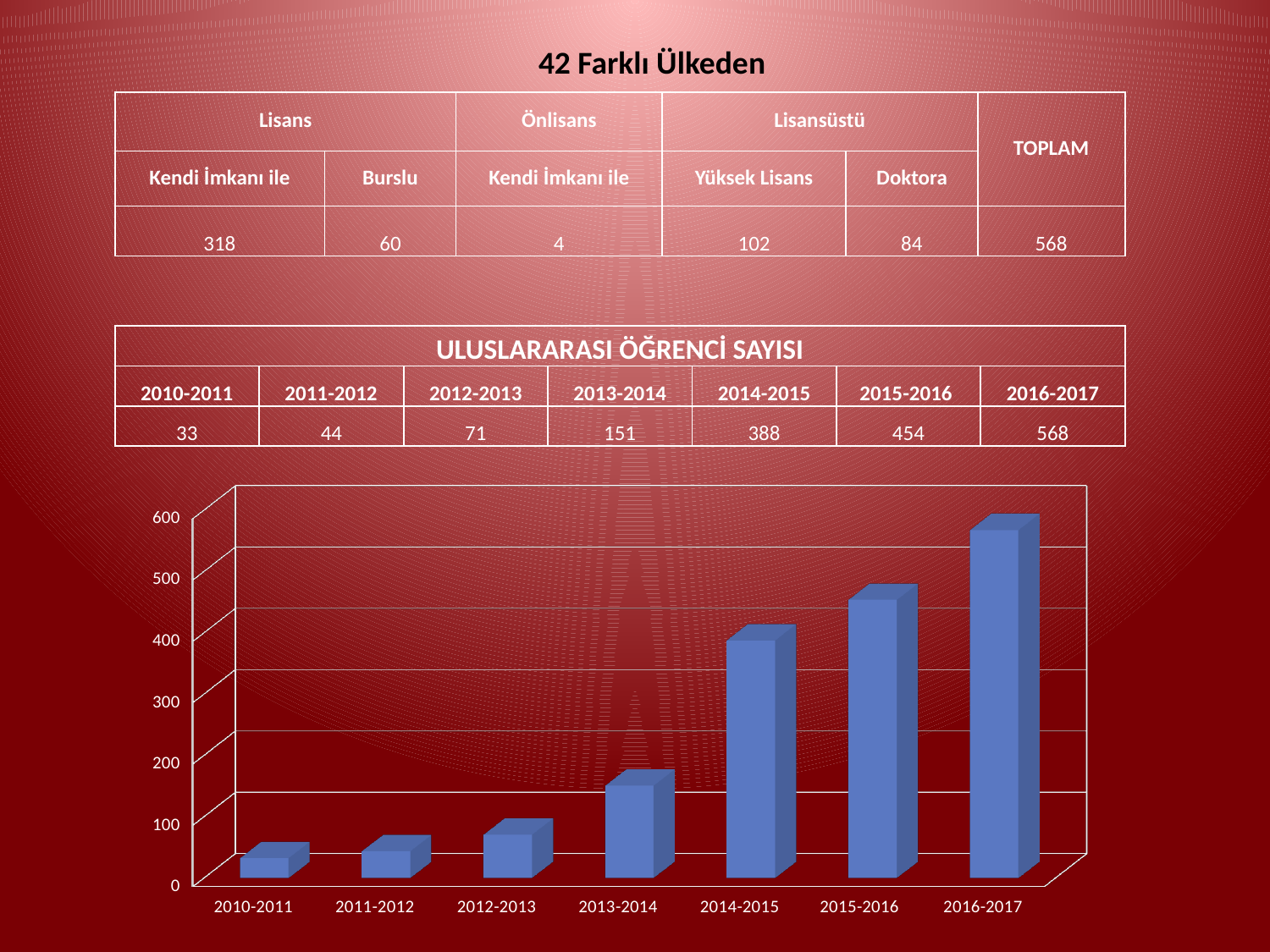
Is the bar for 2012-2013 greater or less than 100? less Which bar is taller, 2015-2016 or 2014-2015? 2015-2016 What is the highest value shown on the chart's vertical axis? 600 Is the bar for 2014-2015 greater or less than 300? greater How many academic-year categories are plotted on the x axis of the chart? 7 Which academic year has the lowest bar in the chart? 2010-2011 Is the bar for 2016-2017 greater or less than 500? greater Do the bar values rise or fall from 2010-2011 to 2016-2017? rise Which academic year has the highest bar in the chart? 2016-2017 According to the slide, what is the international student count plotted for 2014-2015? 388 What kind of chart is shown on the slide? bar chart